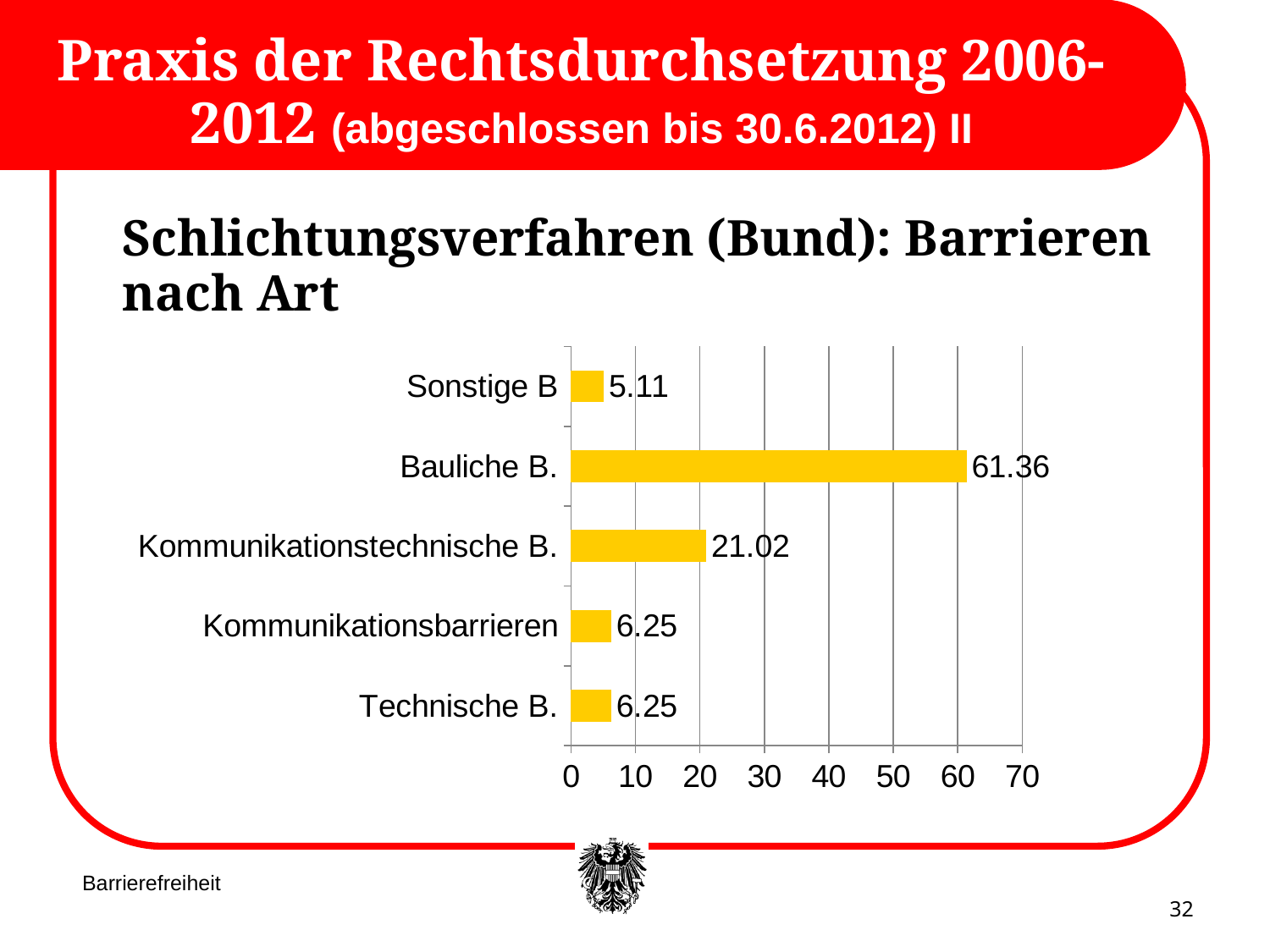
What is the value for Kommunikationstechnische B.? 21.02 What is the difference between the values for Bauliche B. and Kommunikationstechnische B.? 40.34 Which is larger, the value for Kommunikationstechnische B. or the value for Kommunikationsbarrieren? Kommunikationstechnische B. Which category has the lowest value? Sonstige B What is the value for Technische B.? 6.25 What is the value for Bauliche B.? 61.36 What is the heading above the chart? Schlichtungsverfahren (Bund): Barrieren nach Art What is the value for Sonstige B? 5.11 Which category has the highest value? Bauliche B. Is the value for Bauliche B. greater or less than 50? greater What kind of chart is shown on the slide? bar chart How many categories are shown in the chart? 5